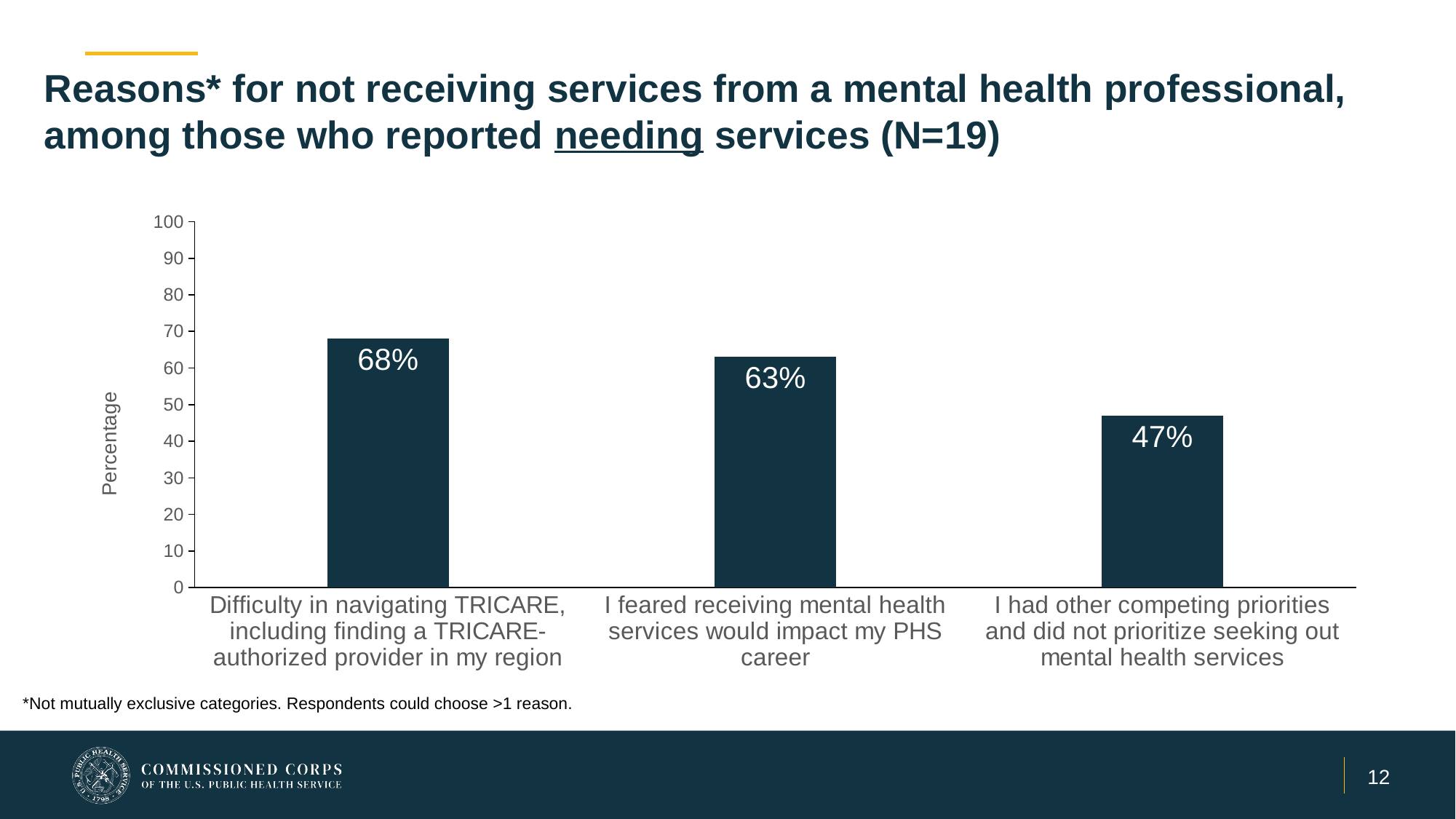
What percentage of respondents said they had other competing priorities and did not prioritize seeking out mental health services? 47% What percentage of respondents feared receiving mental health services would impact their PHS career? 63% Which reason has the lowest percentage? I had other competing priorities and did not prioritize seeking out mental health services What kind of chart is shown on the slide? Bar chart What is the difference in percentage points between the TRICARE navigation reason and the fear of career impact reason? 5 How many reasons are shown in the chart? 3 What is the difference in percentage points between the TRICARE navigation reason and the competing priorities reason? 21 What percentage of respondents cited difficulty in navigating TRICARE as a reason for not receiving services? 68% What is the label on the vertical axis of the chart? Percentage Which reason has the highest percentage? Difficulty in navigating TRICARE, including finding a TRICARE-authorized provider in my region Which is larger: the percentage for fearing career impact or the percentage for competing priorities? I feared receiving mental health services would impact my PHS career Is the value for competing priorities greater or less than 50? less